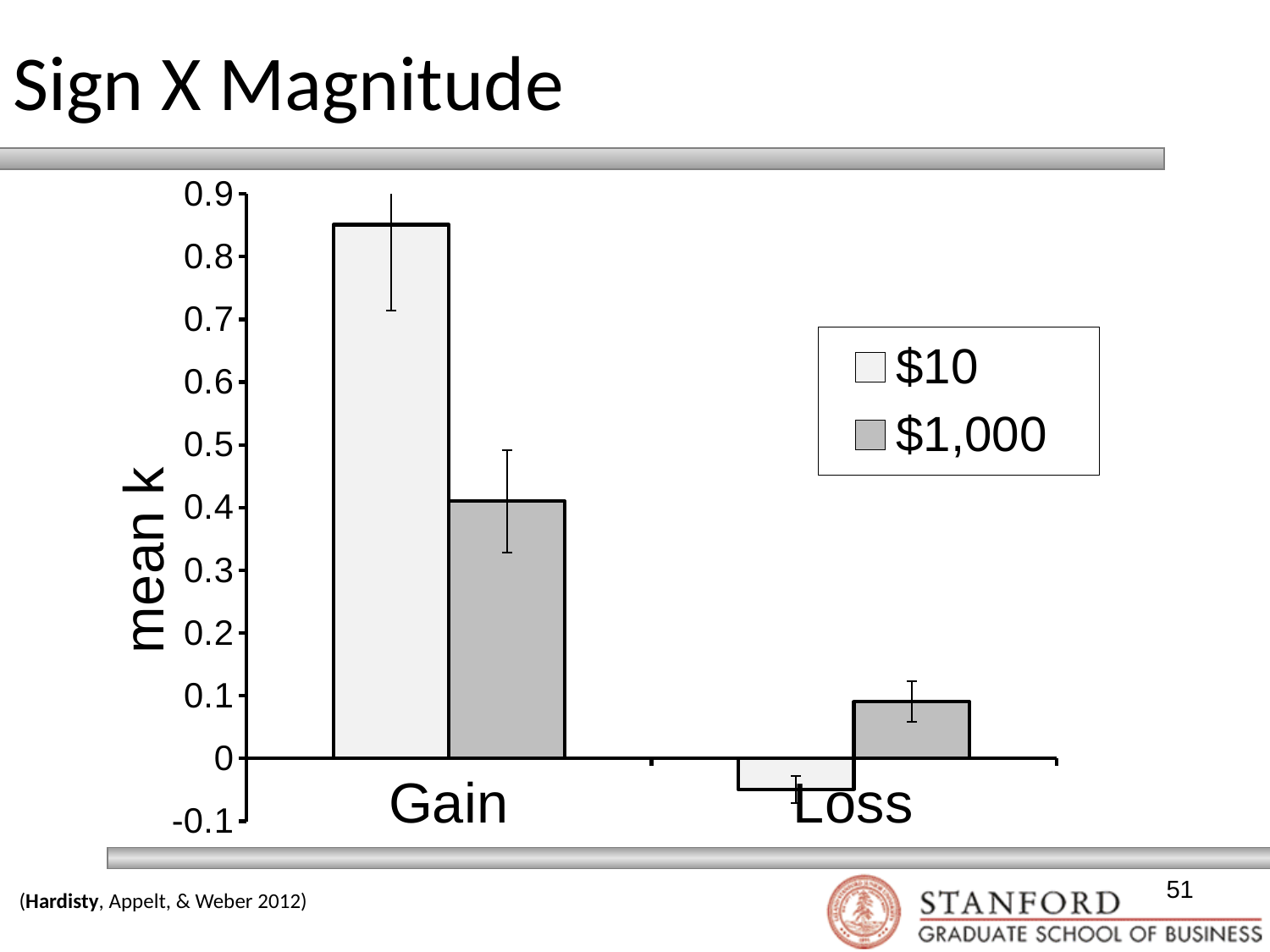
Which bar has the highest mean k? $10 for Gain What is the label on the y axis? mean k Is the mean k for $1,000 in the Gain condition greater or less than 0.5? less What are the two series listed in the legend? $10 and $1,000 Is the mean k for $10 in the Gain condition greater or less than 0.8? greater For Gain, which series has the larger mean k, $10 or $1,000? $10 For Loss, which series has the larger mean k, $10 or $1,000? $1,000 How many categories are shown on the x axis? 2 What kind of chart is shown on the slide? bar chart How many series does the legend list? 2 Which bar has the lowest mean k? $10 for Loss Is the mean k for $10 in the Loss condition greater or less than 0? less